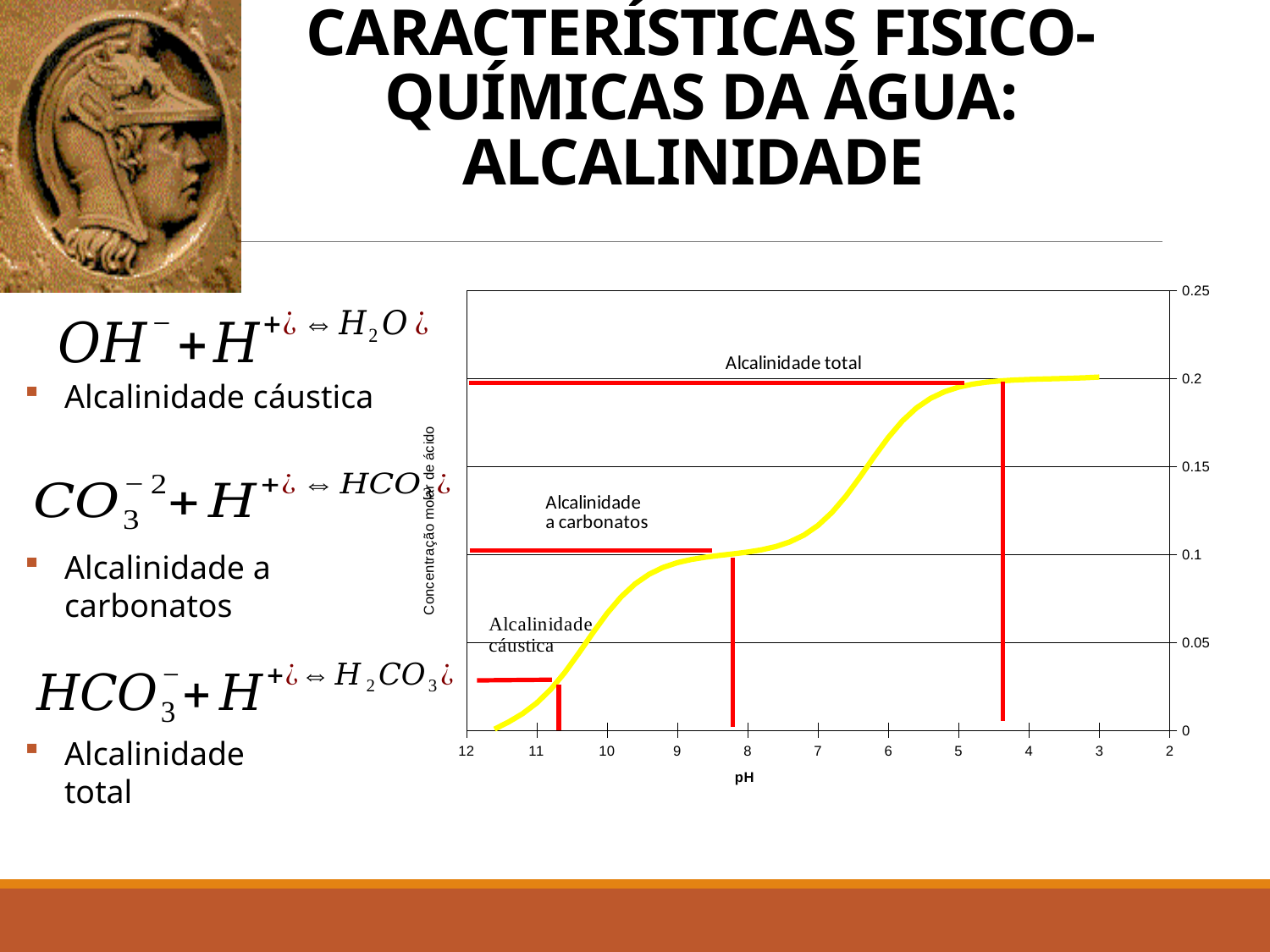
Is the value of the yellow curve at pH 5 greater or less than 0.15? greater What is the highest value shown on the y axis of the chart? 0.25 Does the yellow curve rise or fall from left to right along the x axis? rise Is the value of the yellow curve at pH 11 greater or less than 0.05? less What kind of chart is shown on the slide? line chart At which y-axis value is the red horizontal line labelled 'Alcalinidade a carbonatos' drawn? 0.1 Which has the larger value on the yellow curve, pH 5 or pH 9? pH 5 What is the label of the y axis of the chart? Concentração molar de ácido Is the value of the yellow curve at pH 3 greater or less than 0.15? greater What is the label of the x axis of the chart? pH At which y-axis value is the red horizontal line labelled 'Alcalinidade total' drawn? 0.2